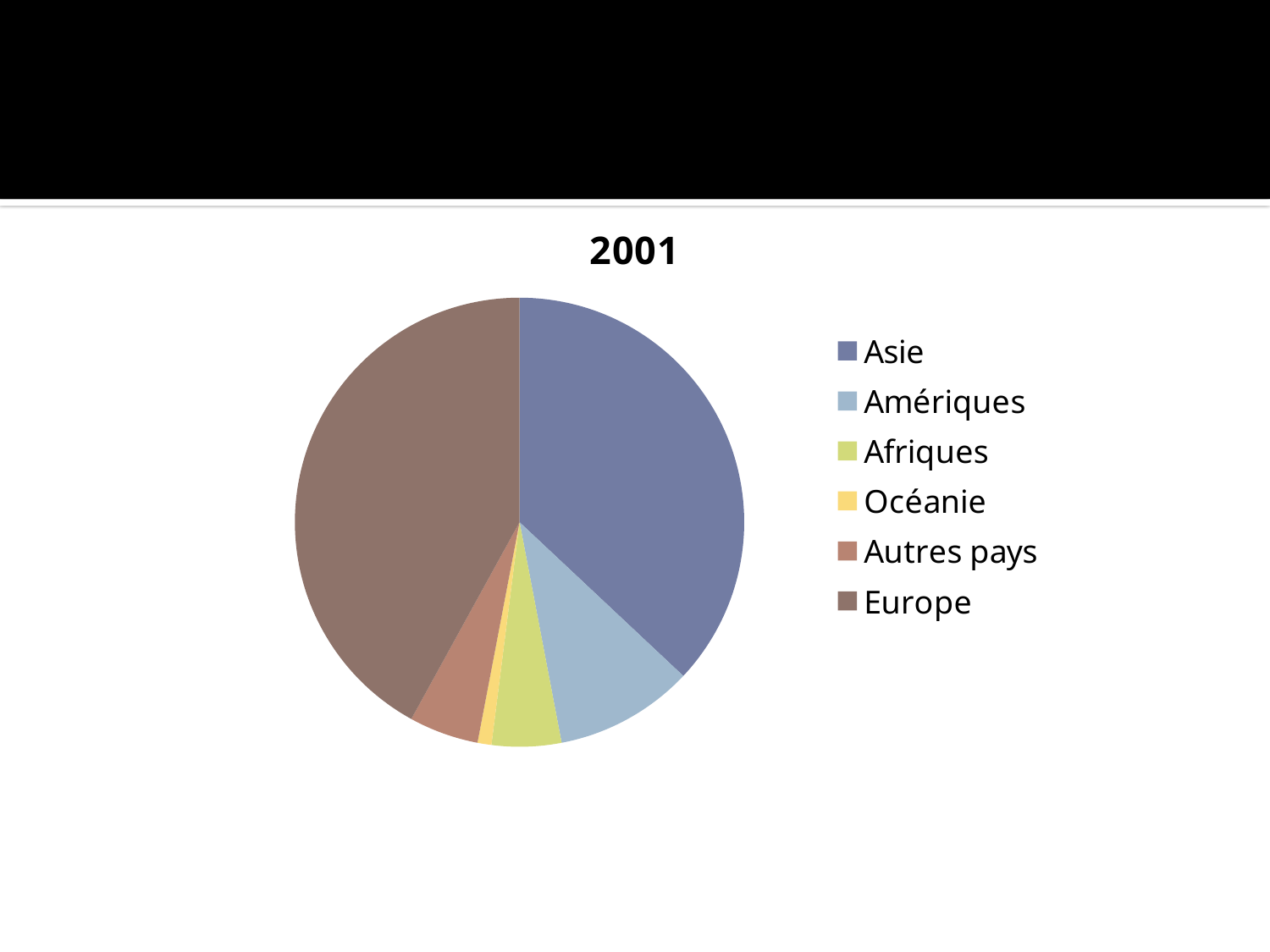
What is the title of the pie chart? 2001 Which slice is larger, Amériques or Afriques? Amériques Which category has the largest slice of the pie? Europe What kind of chart is shown on the slide? pie chart Which categories are listed in the legend of the pie chart? Asie, Amériques, Afriques, Océanie, Autres pays, Europe Which slice is larger, Océanie or Autres pays? Autres pays Is the Europe slice greater or less than half of the pie? less Which slice is larger, Europe or Afriques? Europe Which category has the smallest slice of the pie? Océanie How many categories does the pie chart have? 6